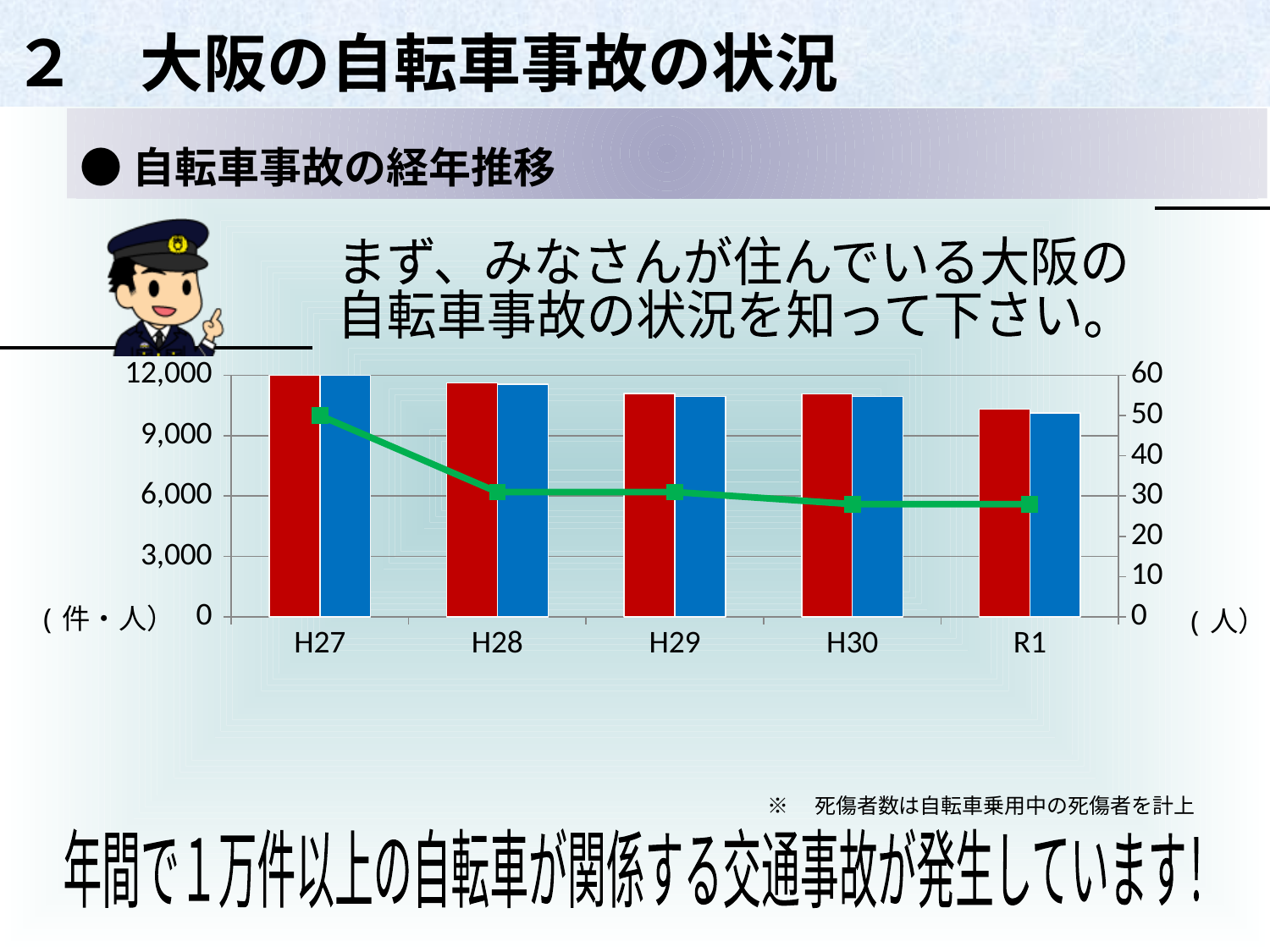
Do the red bars rise or fall from H27 to R1? Fall Which category has the tallest red bar? H27 Is the value of the green line at H27 greater or less than 40? greater How many categories are shown on the x axis of the chart? 5 What is the maximum value shown on the right-hand axis of the chart? 60 What kind of chart is shown on the slide? A bar chart combined with a line chart Which category has the shortest blue bar? R1 Does the green line rise or fall from H27 to R1? Fall Is the blue bar for R1 greater or less than 12,000? less Is the red bar for R1 greater or less than 9,000? greater Which is larger, the green line value at H27 or at H28? H27